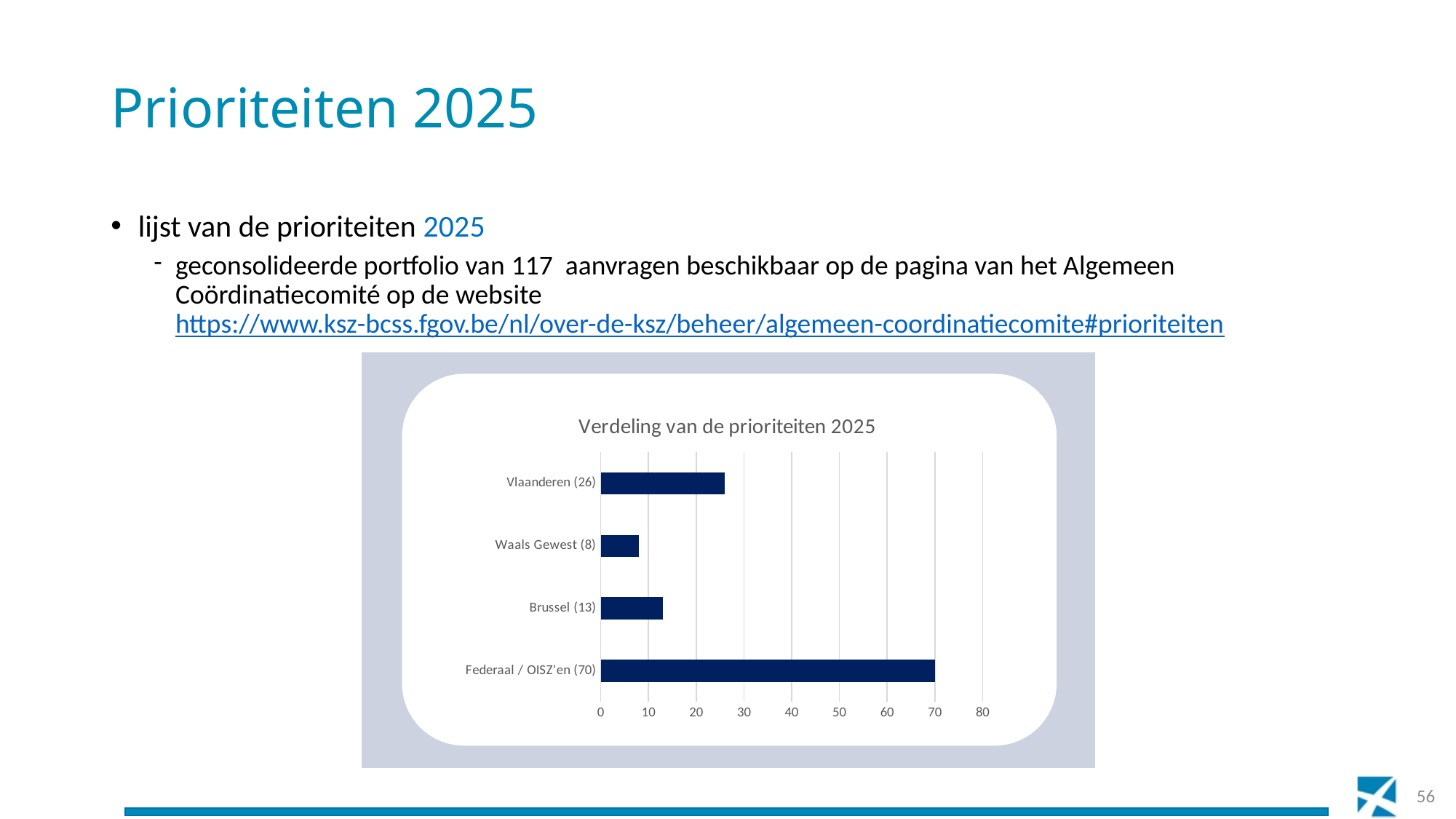
What is the value for Federaal / OISZ'en? 70 What type of chart is shown on the slide? bar chart Which category has the lowest value? Waals Gewest What is the value for Vlaanderen? 26 How many categories are shown in the chart? 4 What is the value for Brussel? 13 What is the value for Waals Gewest? 8 What is the difference between the values for Federaal / OISZ'en and Vlaanderen? 44 What is the title of the chart? Verdeling van de prioriteiten 2025 Is the value for Vlaanderen greater or less than 20? greater Which is larger, the value for Brussel or the value for Waals Gewest? Brussel Which category has the highest value? Federaal / OISZ'en